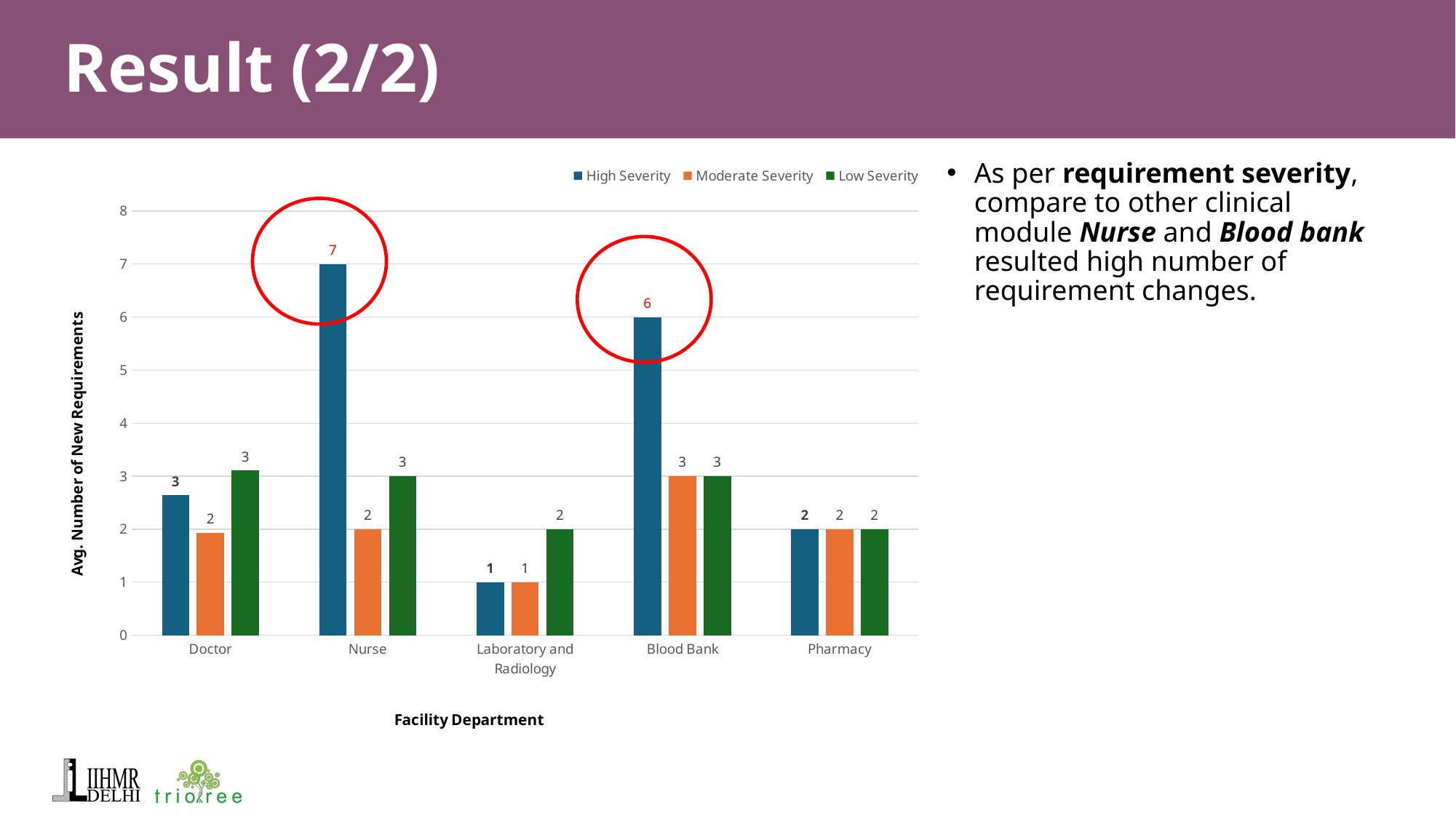
Which facility department has the lowest High Severity value? Laboratory and Radiology How many series does the legend list? 3 What is the Low Severity value for Laboratory and Radiology? 2 What kind of chart is shown on the slide? Bar chart What is the Moderate Severity value for Pharmacy? 2 What is the difference between the High Severity values for Nurse and Blood Bank? 1 What is the High Severity value for Nurse? 7 How many facility departments are shown on the x axis? 5 What is the title of the y axis? Avg. Number of New Requirements What is the High Severity value for Blood Bank? 6 Which facility department has the highest High Severity value? Nurse Which is larger: the High Severity value for Nurse or the Low Severity value for Nurse? High Severity